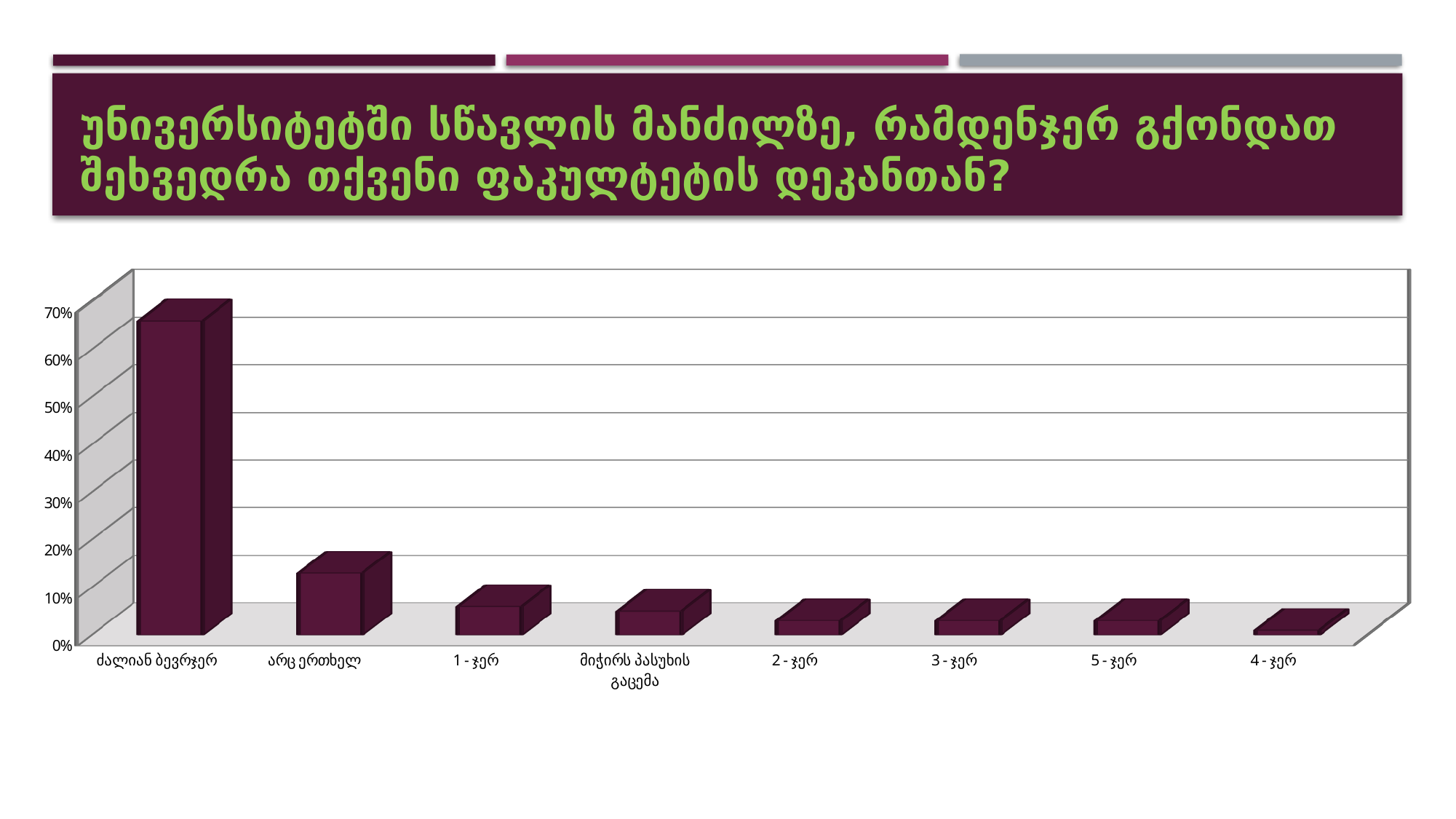
Is the value for ძალიან ბევრჯერ greater or less than 60%? greater Which is larger, the value for 1 - ჯერ or the value for 4 - ჯერ? 1 - ჯერ How many categories are shown on the x axis of the chart? 8 Which category has the highest value in the chart? ძალიან ბევრჯერ Is the value for არც ერთხელ greater or less than 20%? less Which is larger, the value for არც ერთხელ or the value for 1 - ჯერ? არც ერთხელ What kind of chart is shown on the slide? bar chart What is the highest value labelled on the vertical axis of the chart? 70% Which is larger, the value for ძალიან ბევრჯერ or the value for არც ერთხელ? ძალიან ბევრჯერ Is the value for 1 - ჯერ greater or less than 10%? less Which category has the lowest value in the chart? 4 - ჯერ